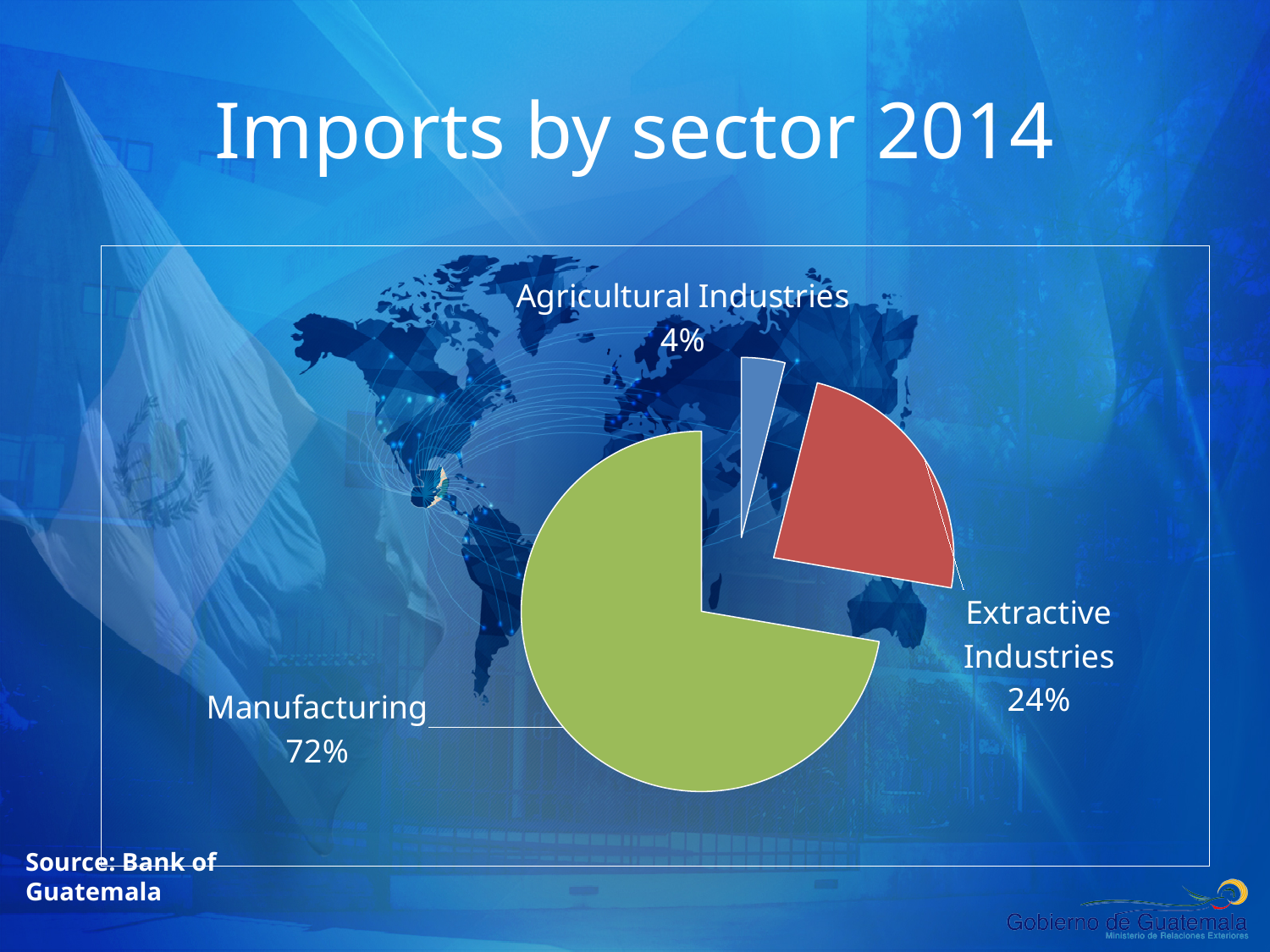
Which has a larger share, Extractive Industries or Agricultural Industries? Extractive Industries What share of imports does Manufacturing account for? 72% What share of imports does Agricultural Industries account for? 4% Which sector has the smallest share of imports? Agricultural Industries What is the difference in percentage points between Extractive Industries and Agricultural Industries? 20 Which sector has the largest share of imports? Manufacturing What share of imports does Extractive Industries account for? 24% What is the title of the slide? Imports by sector 2014 What colour is the Manufacturing slice? green What is the difference in percentage points between Manufacturing and Extractive Industries? 48 How many sectors are shown in the pie chart? 3 What kind of chart is shown on the slide? pie chart